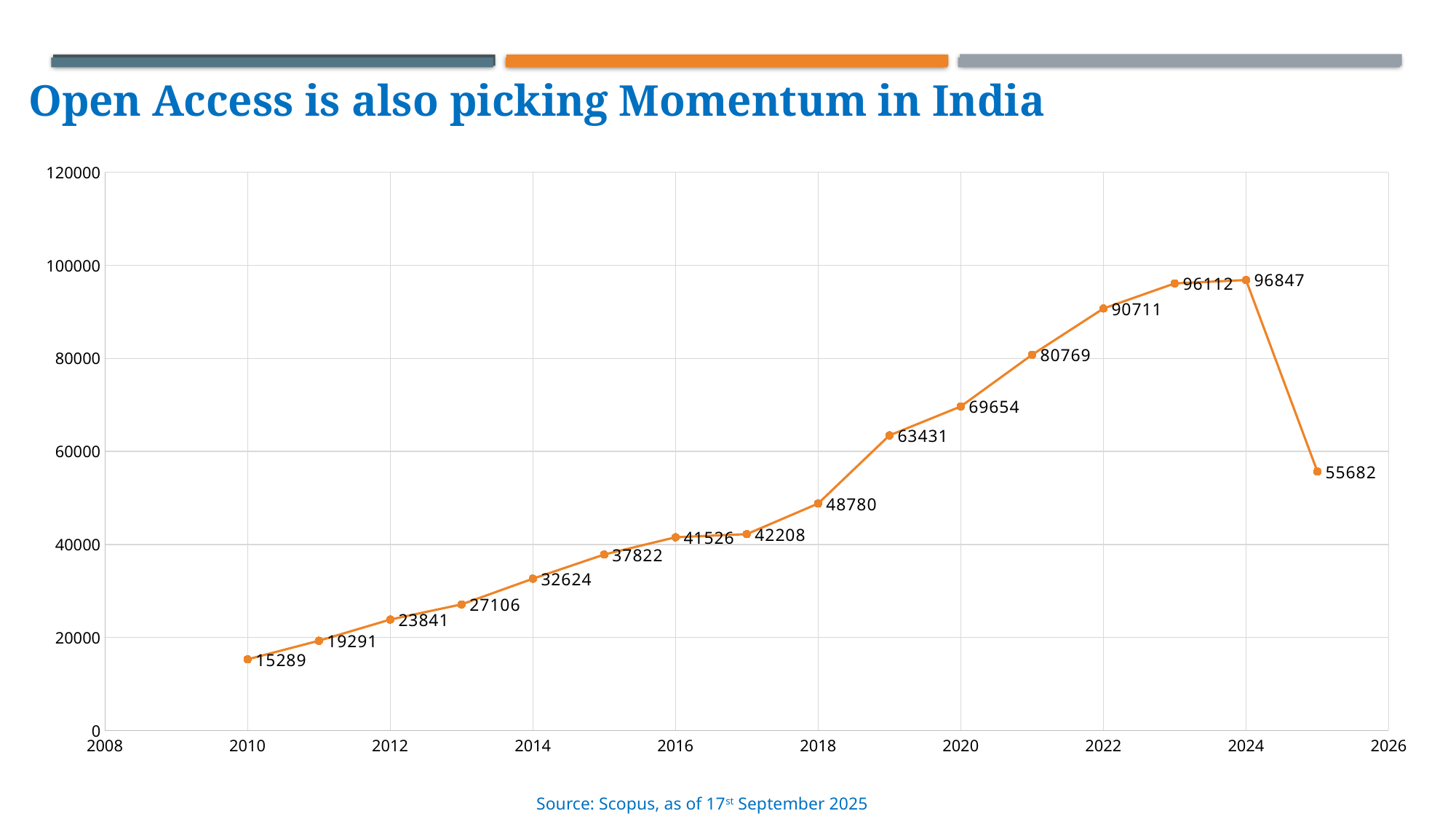
What is the difference between the values for 2024 and 2023? 735 What is the value plotted for 2024? 96847 What is the difference between the values for 2024 and 2025? 41165 What is the value plotted for 2025? 55682 Which year has the lowest value on the chart? 2010 What is the title of the slide? Open Access is also picking Momentum in India How many data points are plotted on the chart? 16 Which year has the highest value on the chart? 2024 What kind of chart is shown on the slide? line chart Which is larger, the value for 2019 or the value for 2018? 2019 What is the value plotted for 2010? 15289 What is the value plotted for 2018? 48780